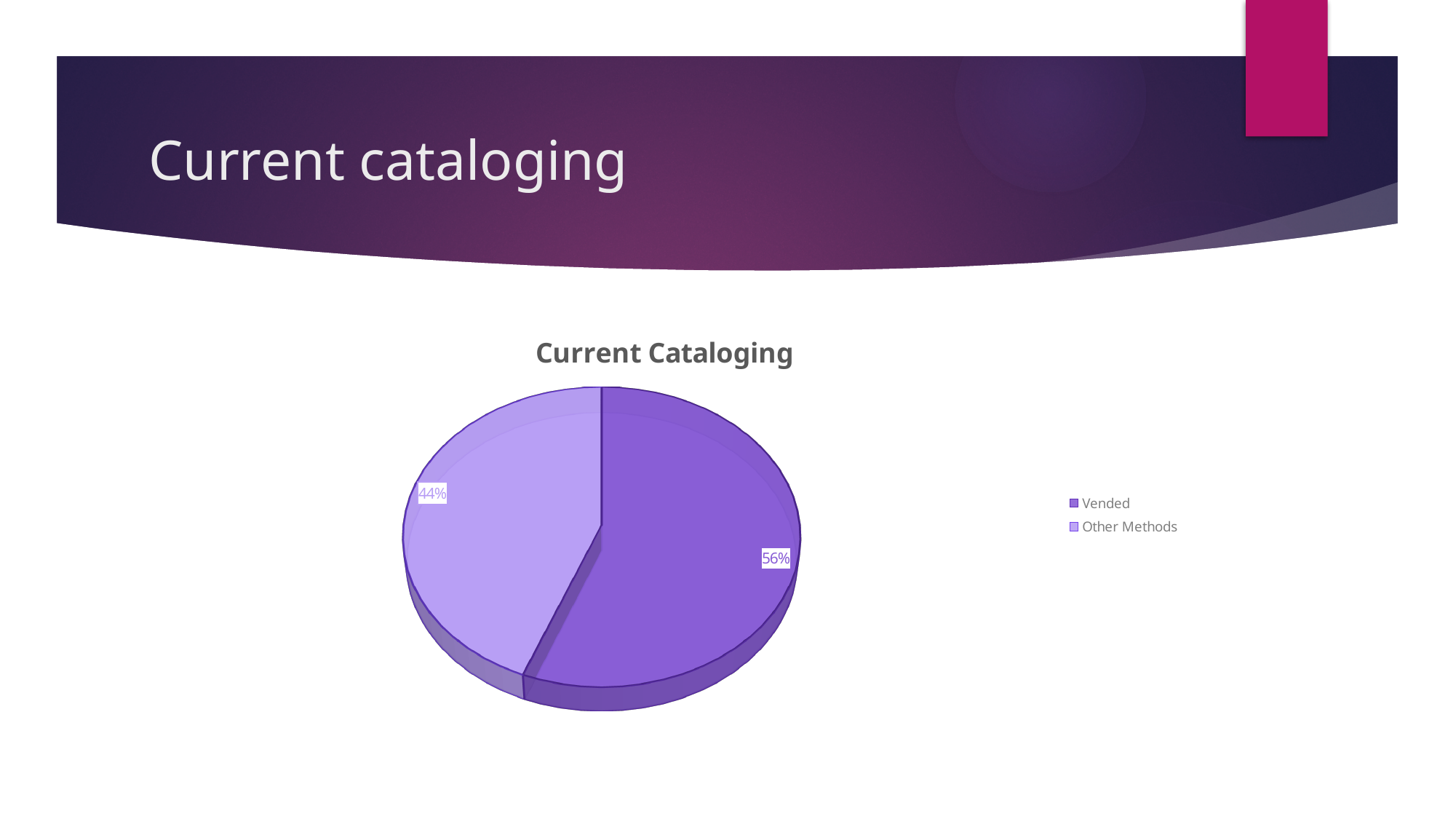
How many slices does the pie chart have? 2 Which slice is the smallest? Other Methods Which slice is the largest? Vended Is the value for Other Methods greater or less than 50%? less Which is larger, Vended or Other Methods? Vended What is the difference in percentage points between Vended and Other Methods? 12 Which legend entry is shown in the lighter purple colour? Other Methods What share of the pie does Other Methods account for? 44% What is the title of the chart? Current Cataloging How many entries does the legend list? 2 What kind of chart is shown on the slide? pie chart What share of the pie does Vended account for? 56%